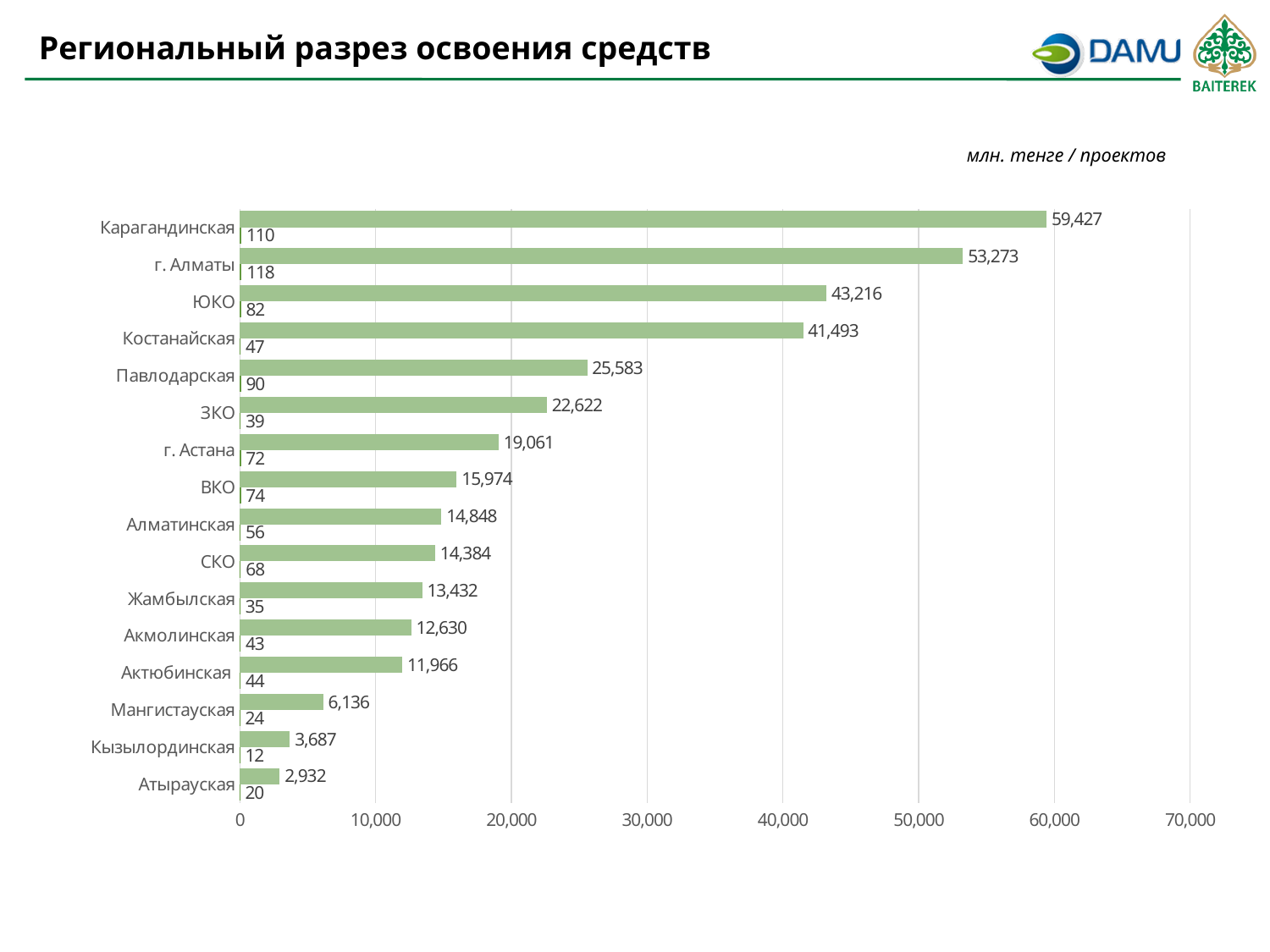
Which region has the lowest number of projects? Кызылординская What is the amount in million tenge for Карагандинская? 59,427 What is the amount in million tenge for Мангистауская? 6,136 What is the difference in million tenge between Карагандинская and г. Алматы? 6,154 Which region has the highest amount in million tenge? Карагандинская How many regions are shown in the chart? 16 What kind of chart is shown on the slide? bar chart How many projects are shown for г. Астана? 72 Is the amount for Павлодарская greater or less than 20,000? greater Which region has the lowest amount in million tenge? Атырауская Which region has the highest number of projects? г. Алматы Which has a larger amount in million tenge, ЮКО or Костанайская? ЮКО